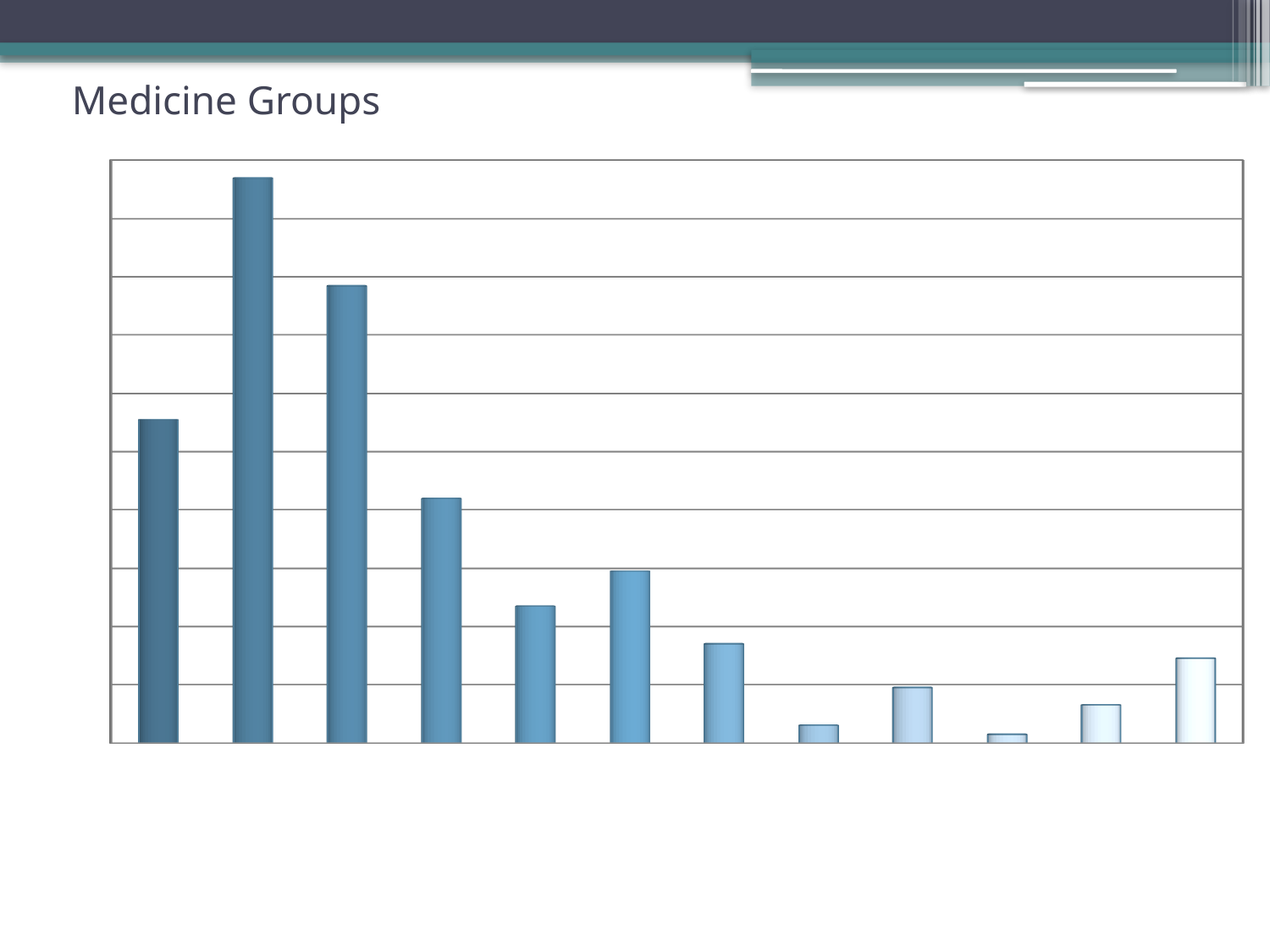
How many bars does the chart contain? 12 Which bar, counting from the left, is the shortest in the chart? the tenth bar Which is taller, the fourth bar from the left or the sixth bar from the left? the fourth bar Which is taller, the eleventh bar from the left or the twelfth bar from the left? the twelfth bar What is the title shown above the chart on the slide? Medicine Groups Does the chart display a legend? No Which is taller, the first bar from the left or the third bar from the left? the third bar Which bar, counting from the left, is the tallest in the chart? the second bar What kind of chart is shown on the slide? bar chart